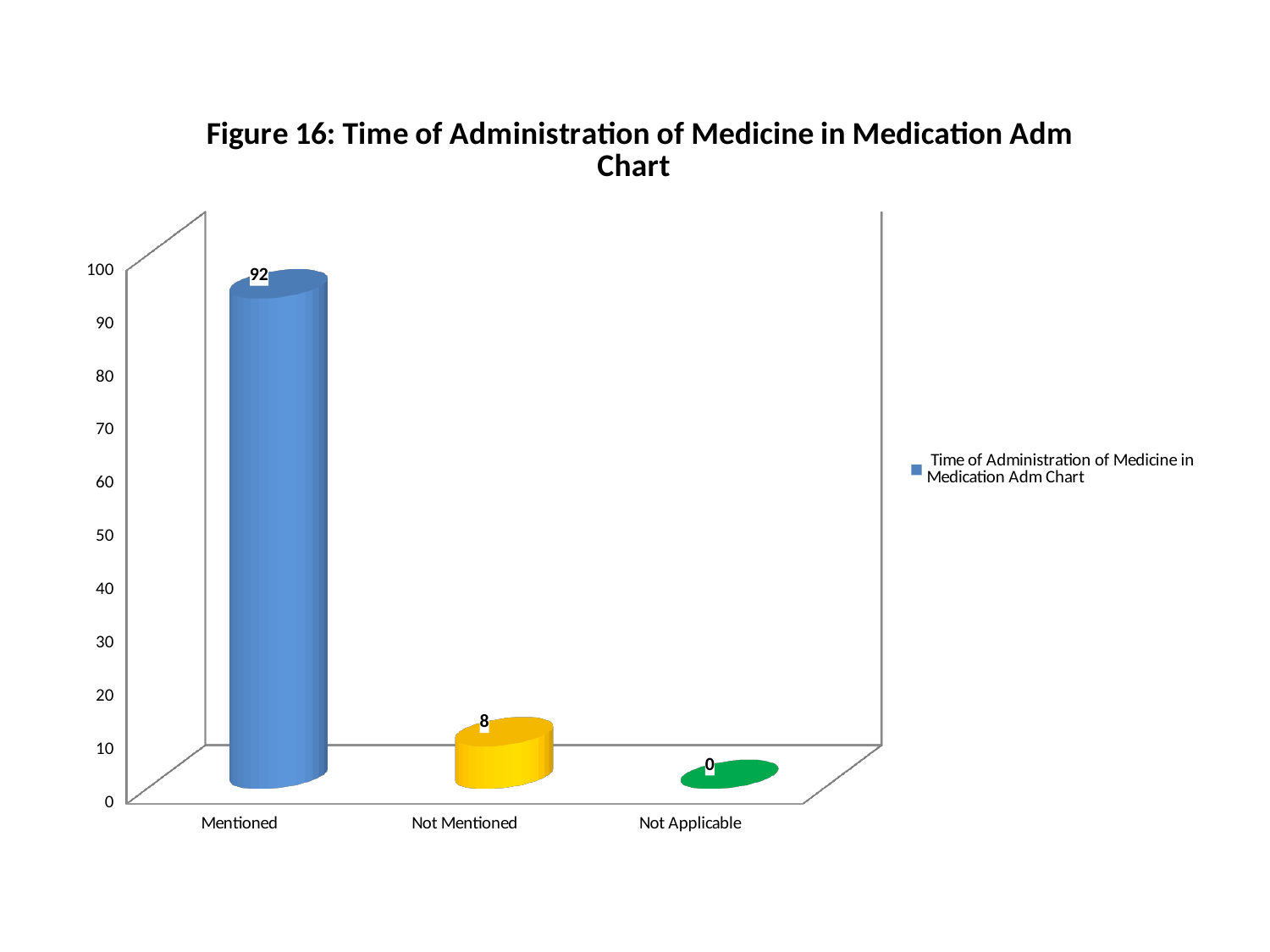
What kind of chart is shown on the slide? bar chart What is the value for Not Applicable? 0 What is the value for Not Mentioned? 8 How many categories are shown on the x axis? 3 Which category has the highest value? Mentioned Which is larger, the value for Not Mentioned or the value for Not Applicable? Not Mentioned What is the value for Mentioned? 92 Which category has the lowest value? Not Applicable What is the difference between the values for Mentioned and Not Mentioned? 84 What is the title of the chart? Figure 16: Time of Administration of Medicine in Medication Adm Chart Is the value for Mentioned greater or less than 50? greater How many series does the legend list? 1